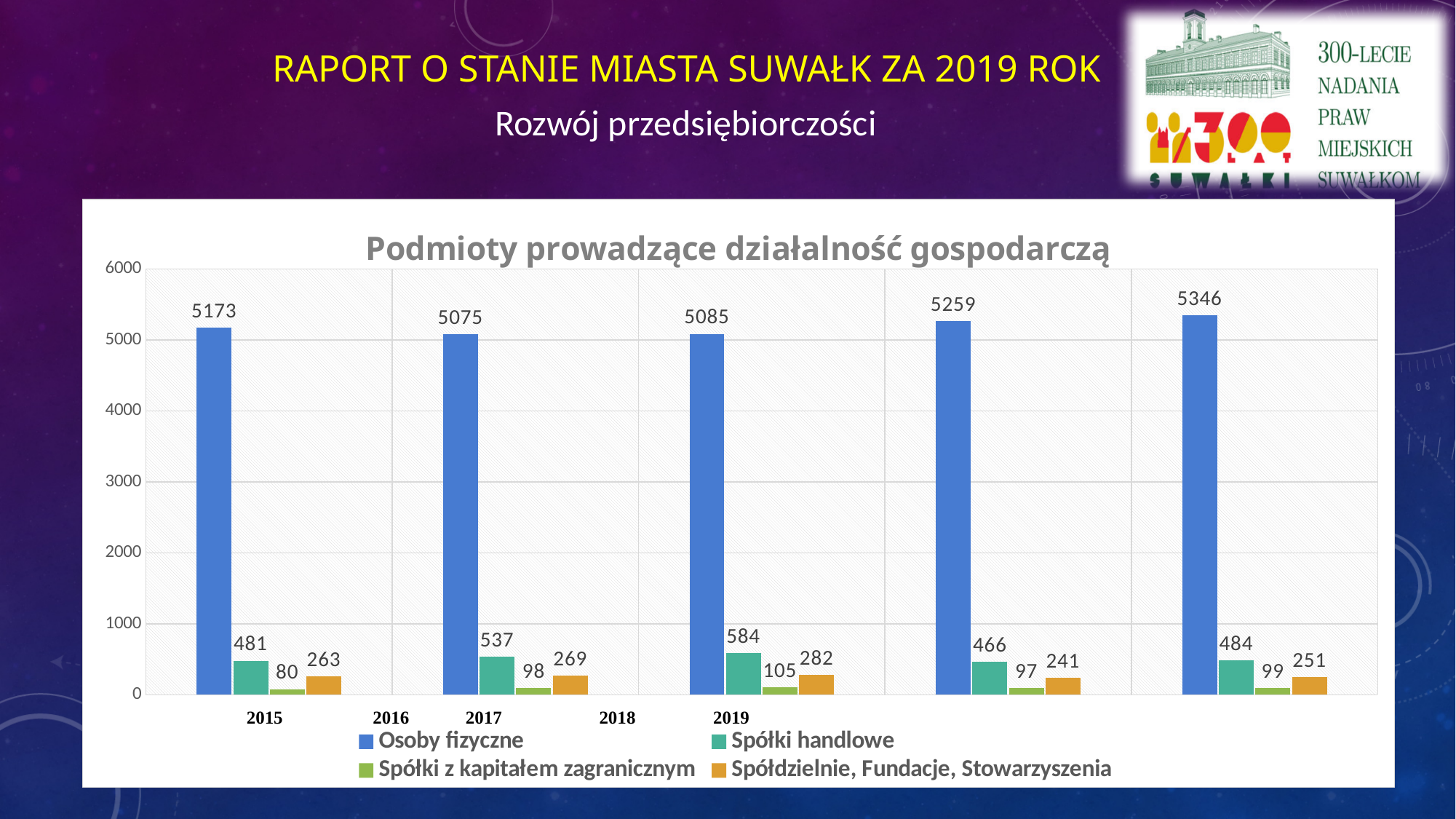
How many series does the legend list? 4 What type of chart is shown on the slide? bar chart What is the value for Osoby fizyczne in 2019? 5346 In which year is the value for Spółdzielnie, Fundacje, Stowarzyszenia the highest? 2017 Which is larger, the Spółki handlowe value in 2016 or in 2019? 2016 How many year categories are shown on the x axis? 5 What is the value for Spółki handlowe in 2017? 584 What is the value for Spółki z kapitałem zagranicznym in 2015? 80 Is the value for Osoby fizyczne in 2015 greater or less than 5000? greater What is the title of the chart? Podmioty prowadzące działalność gospodarczą What is the difference between the Osoby fizyczne values for 2019 and 2018? 87 In which year is the value for Osoby fizyczne the lowest? 2016